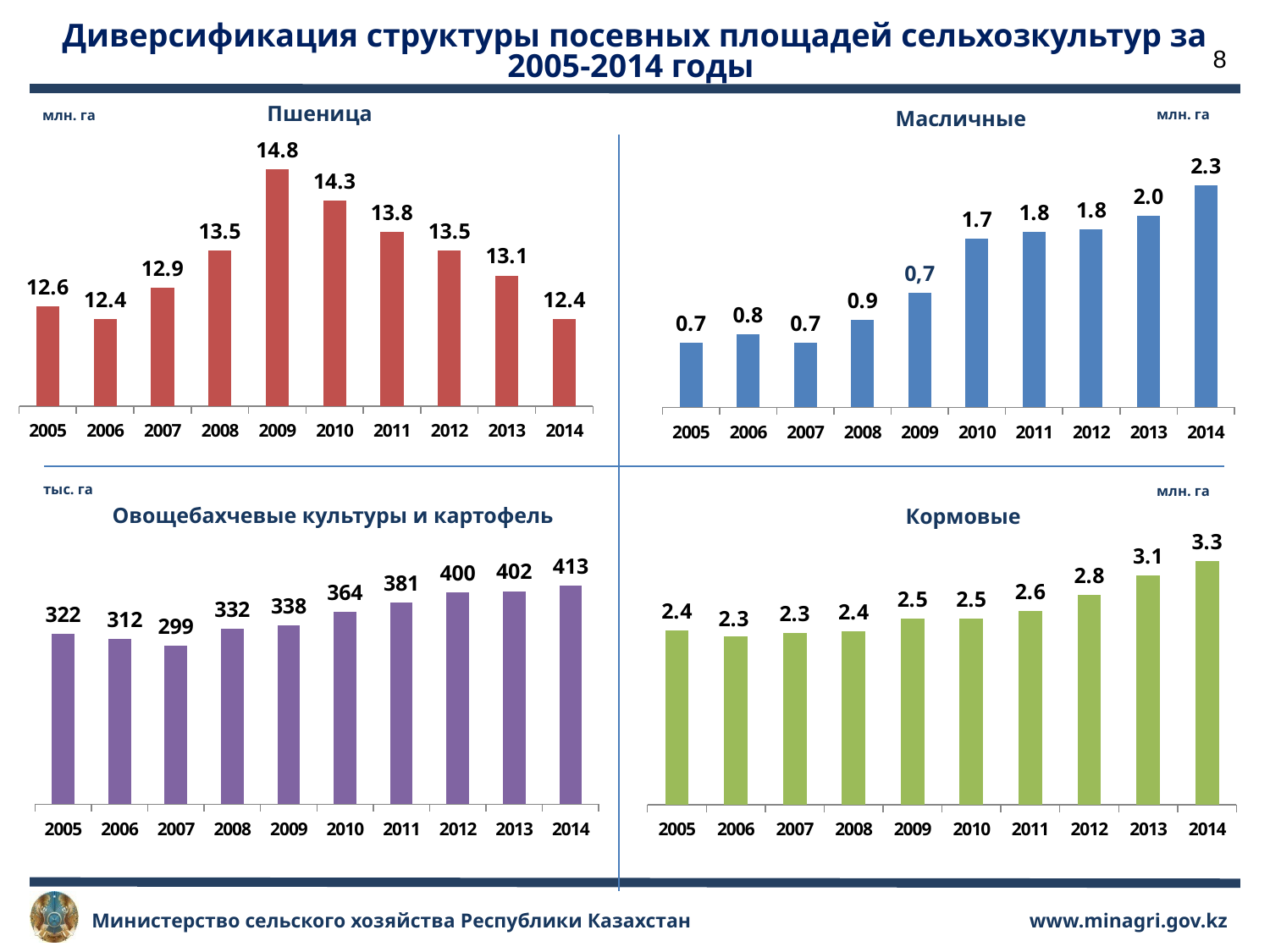
In the 'Пшеница' chart, what is the difference between the values for 2009 and 2014? 2.4 What type of chart is the 'Кормовые' chart? bar chart In the 'Масличные' chart, what is the value for 2014? 2.3 In the 'Кормовые' chart, what is the value for 2013? 3.1 In the 'Овощебахчевые культуры и картофель' chart, what is the difference between the values for 2014 and 2005? 91 In the 'Пшеница' chart, which year has the highest value? 2009 In the 'Масличные' chart, which year has the highest value? 2014 In the 'Кормовые' chart, is the value for 2014 larger or smaller than the value for 2005? larger In the 'Масличные' chart, how many years are shown on the x axis? 10 In the 'Овощебахчевые культуры и картофель' chart, which year has the lowest value? 2007 In the 'Овощебахчевые культуры и картофель' chart, what is the value for 2007? 299 In the 'Пшеница' chart, what is the value for 2009? 14.8